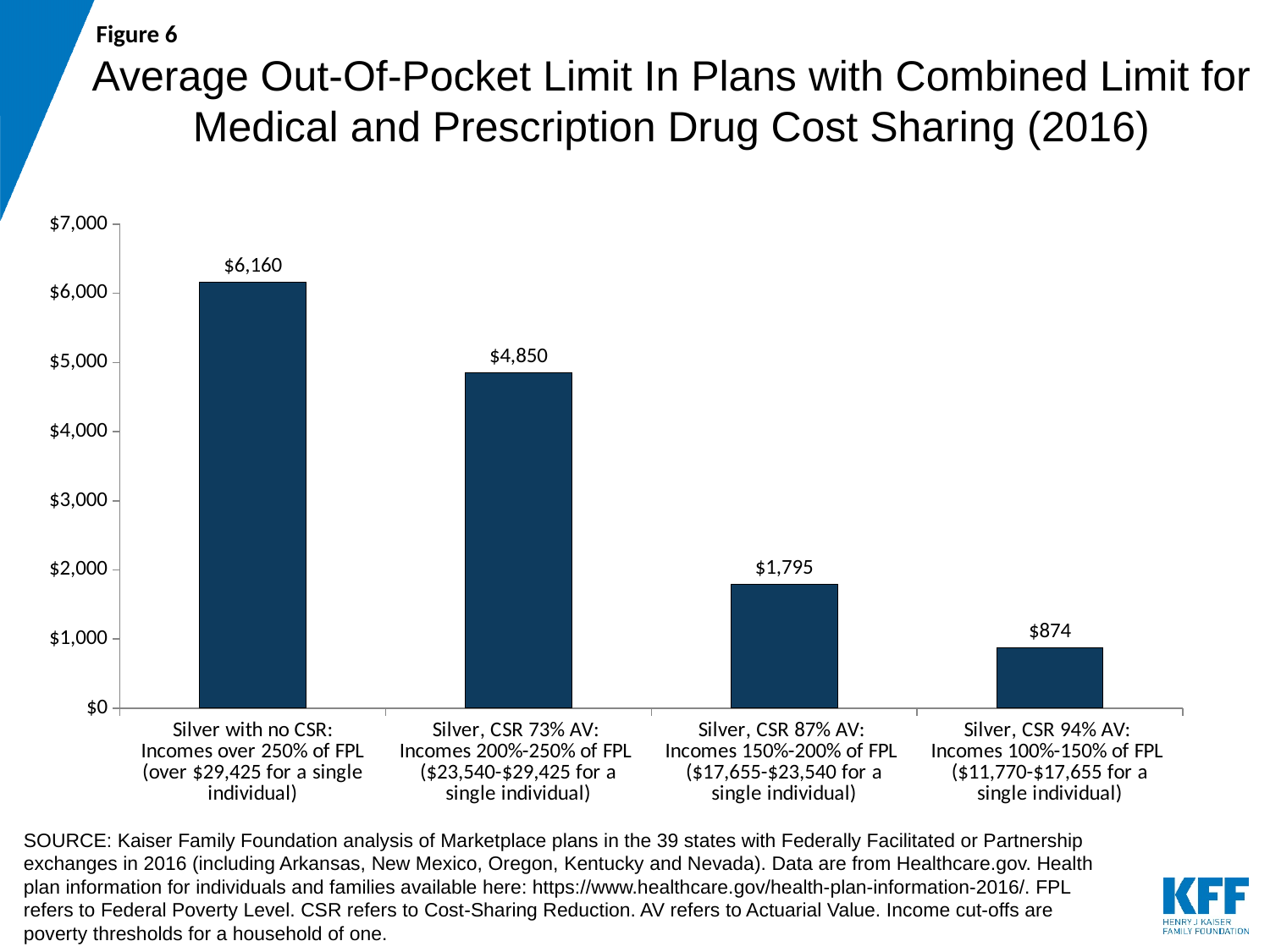
What is the difference between the average out-of-pocket limit for Silver, CSR 87% AV and Silver, CSR 94% AV plans? $921 How many plan categories are shown in the chart? 4 Which plan category has the lowest average out-of-pocket limit? Silver, CSR 94% AV What kind of chart is shown on the slide? Bar chart What is the average out-of-pocket limit for Silver, CSR 94% AV plans? $874 What is the difference between the average out-of-pocket limit for Silver with no CSR and Silver, CSR 73% AV plans? $1,310 Which plan category has the highest average out-of-pocket limit? Silver with no CSR What is the average out-of-pocket limit for Silver, CSR 73% AV plans? $4,850 Do the values rise or fall moving from left to right across the chart? Fall Which has a larger average out-of-pocket limit: Silver, CSR 73% AV or Silver, CSR 87% AV? Silver, CSR 73% AV What is the average out-of-pocket limit for Silver with no CSR plans? $6,160 What is the average out-of-pocket limit for Silver, CSR 87% AV plans? $1,795